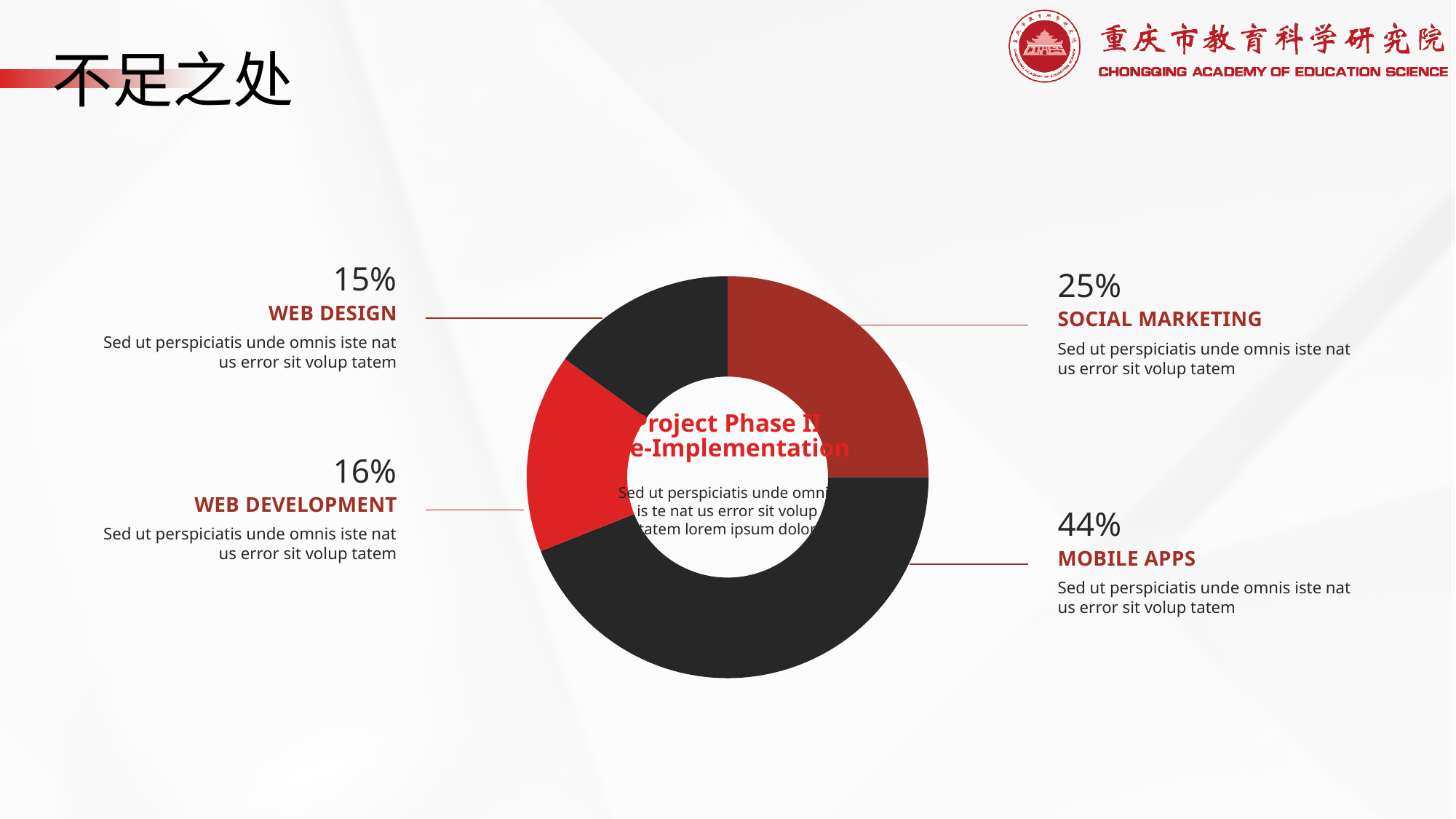
What colour is the Web Development segment of the chart? Red Which category has the largest share of the chart? Mobile Apps How many categories are shown in the chart? 4 What percentage is shown for Social Marketing? 25% What is the difference between the Mobile Apps and Social Marketing percentages? 19% Which category has the smallest share of the chart? Web Design What percentage is shown for Web Design? 15% What is the difference between the Web Development and Web Design percentages? 1% What percentage is shown for Mobile Apps? 44% What percentage is shown for Web Development? 16% What kind of chart is shown on the slide? Donut chart Which is larger, the share for Social Marketing or the share for Web Development? Social Marketing